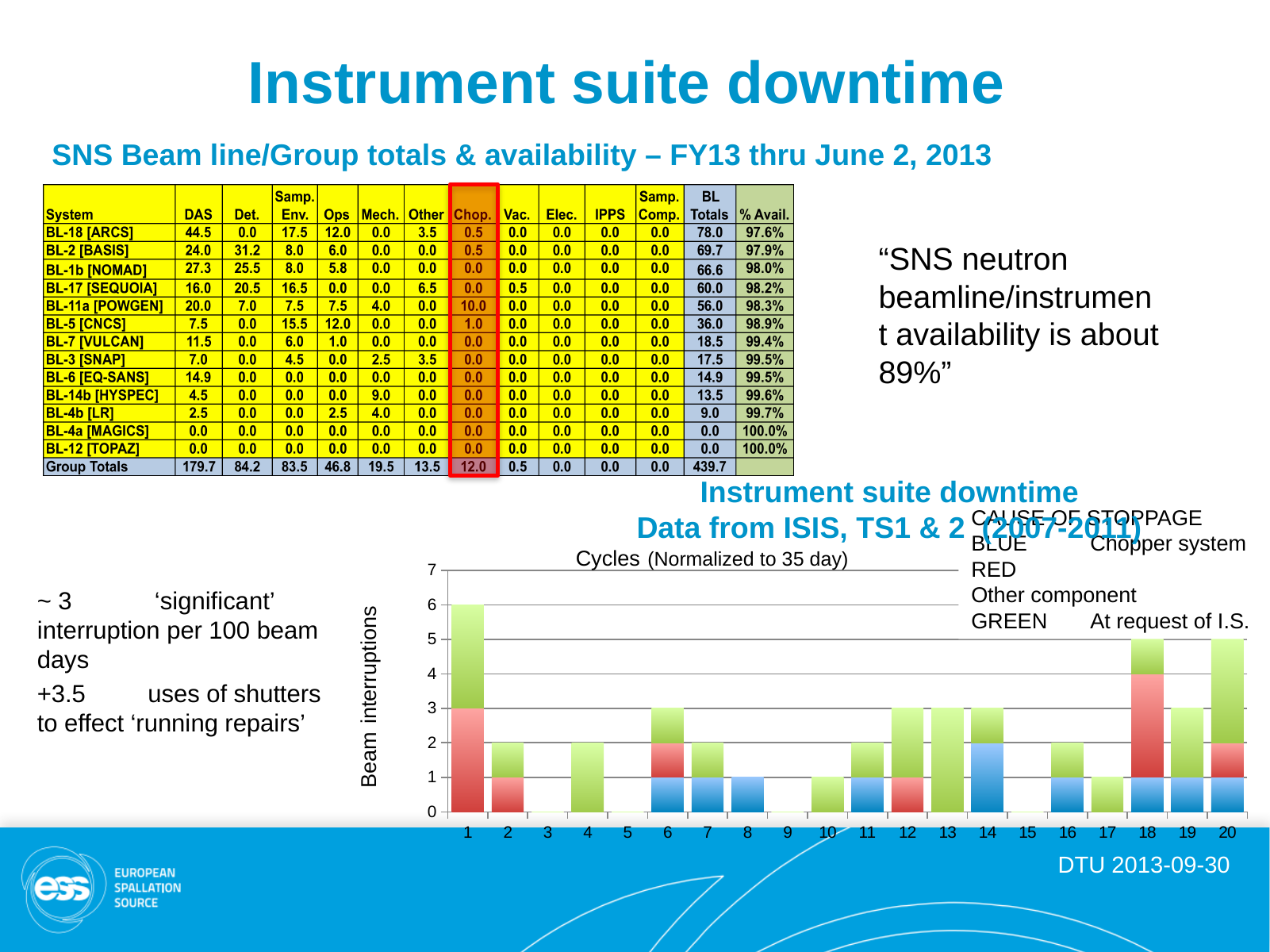
What is the total number of beam interruptions for cycle 13? 3 Is the total number of beam interruptions for cycle 20 greater or less than 4? greater Which has more beam interruptions in total, cycle 6 or cycle 8? Cycle 6 What is the total number of beam interruptions for cycle 18? 5 What is the difference in total beam interruptions between cycle 1 and cycle 18? 1 How many causes of stoppage are listed in the chart's colour key? 3 What is the total number of beam interruptions for cycle 1? 6 According to the colour key, which cause of stoppage is shown in blue? Chopper system Which cycle has the highest total number of beam interruptions? Cycle 1 How many cycles are shown on the x axis of the beam interruptions chart? 20 What kind of chart is shown at the bottom of the slide? Stacked bar chart What is the label of the y axis of the beam interruptions chart? Beam interruptions